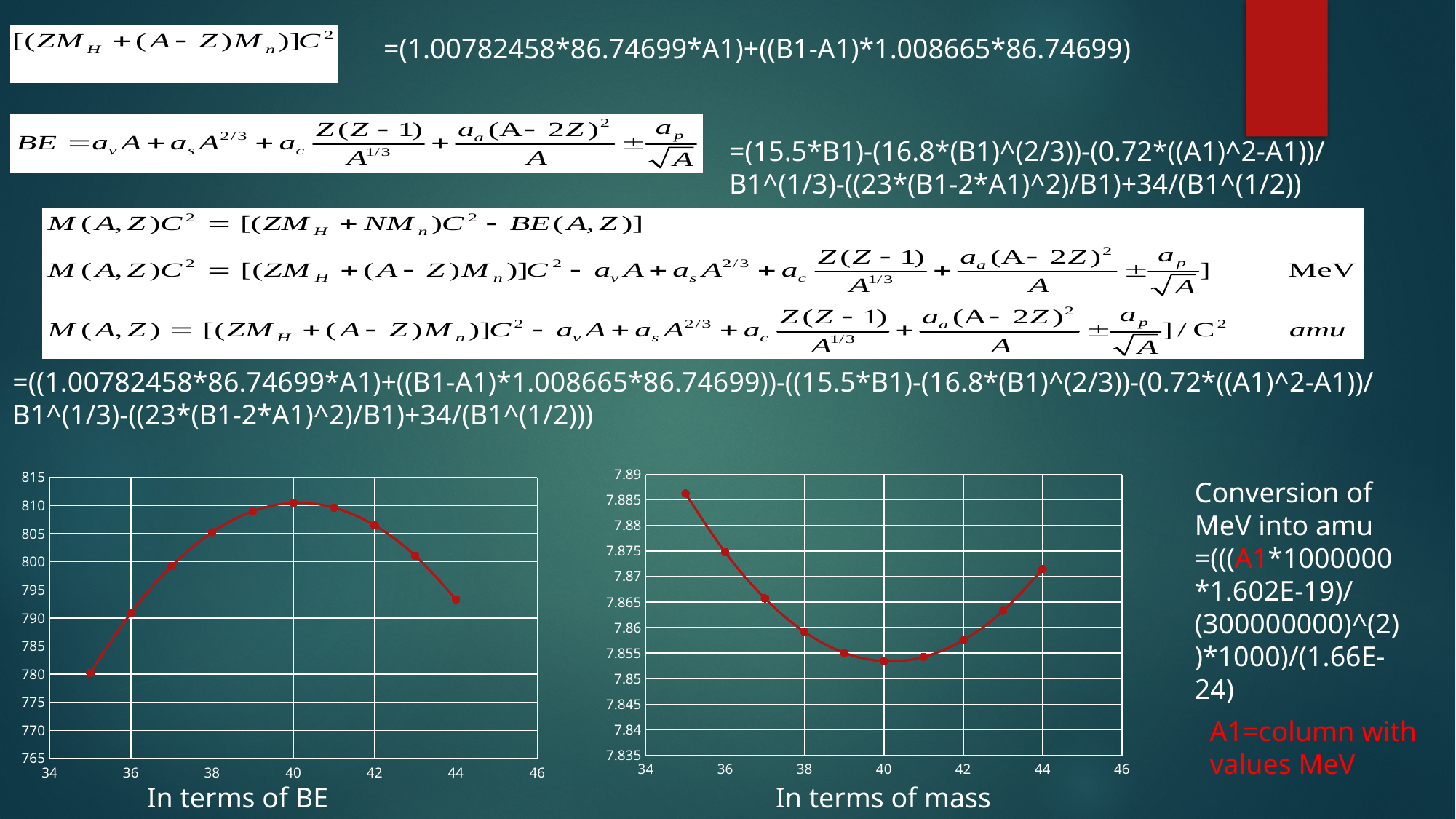
What type of chart is the 'In terms of BE' chart? line chart On the 'In terms of BE' chart, at which x value does the curve reach its highest point? 40 On the 'In terms of mass' chart, at which x value does the curve reach its lowest point? 40 On the 'In terms of BE' chart, at which x value is the lowest point? 35 On the 'In terms of mass' chart, at which x value is the highest point? 35 On the 'In terms of BE' chart, is the value at x = 40 greater or less than 805? greater How many data points are plotted on the 'In terms of mass' chart? 10 On the 'In terms of mass' chart, how do the values change as x increases from 35 to 44? They fall to a minimum at 40, then rise On the 'In terms of mass' chart, is the value at x = 35 greater or less than 7.88? greater On the 'In terms of BE' chart, is the value at x = 44 greater or less than 795? less On the 'In terms of BE' chart, which has the larger value: x = 36 or x = 43? 43